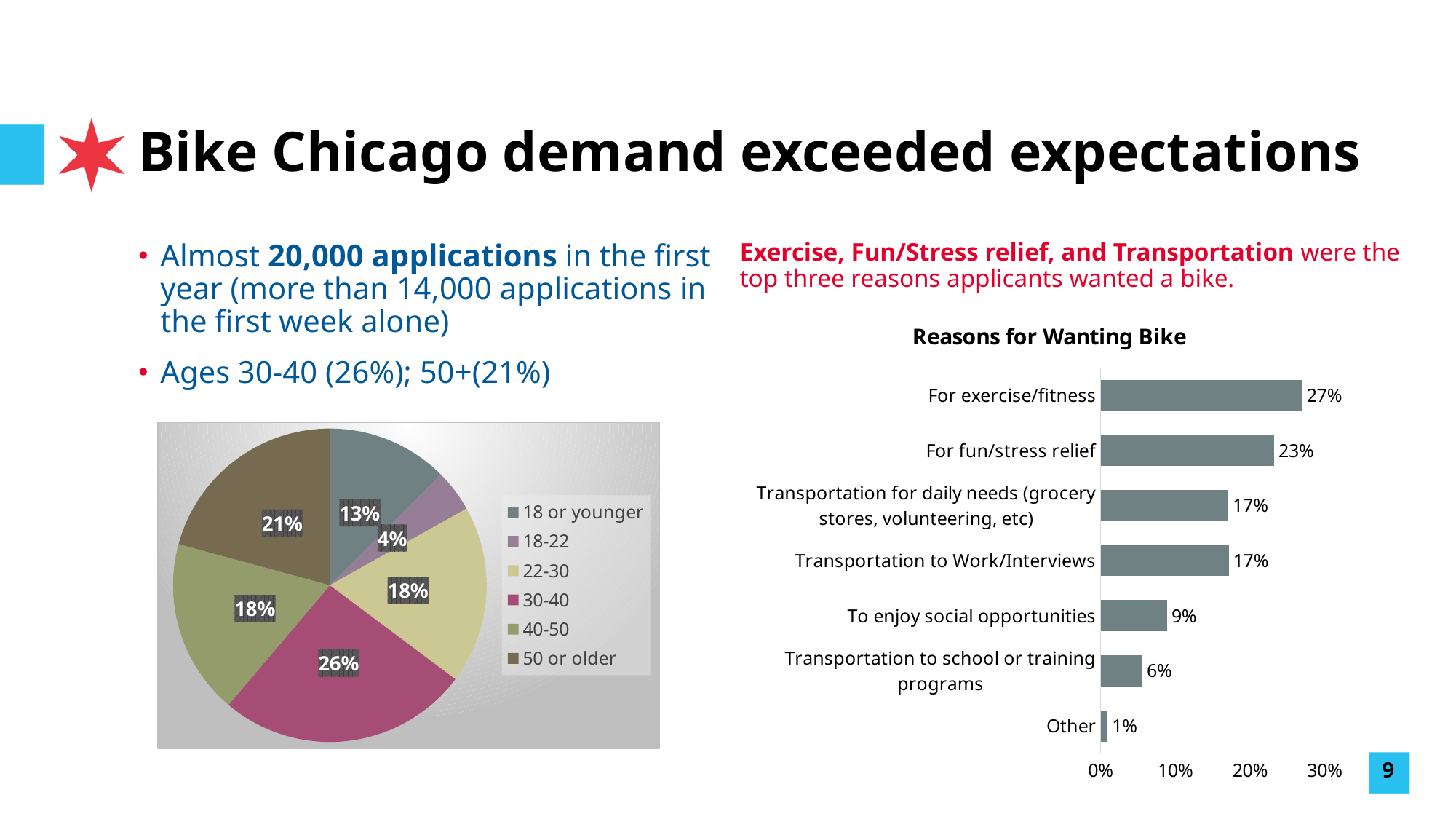
In the pie chart on the left, what share does the '30-40' age group have? 26% In the 'Reasons for Wanting Bike' bar chart, how many reasons (categories) are shown? 7 In the 'Reasons for Wanting Bike' bar chart, which reason has the lowest value? Other In the pie chart on the left, which age group has the largest slice? 30-40 What kind of chart is the 'Reasons for Wanting Bike' chart? bar chart In the 'Reasons for Wanting Bike' bar chart, what is the difference between 'For exercise/fitness' and 'For fun/stress relief'? 4% In the pie chart on the left, which age group has the smallest slice? 18-22 In the 'Reasons for Wanting Bike' bar chart, which reason has the highest value? For exercise/fitness In the pie chart on the left, which is larger: the '50 or older' slice or the '18 or younger' slice? 50 or older In the 'Reasons for Wanting Bike' bar chart, what is the value for 'For exercise/fitness'? 27% In the pie chart on the left, how many age groups does the legend list? 6 In the 'Reasons for Wanting Bike' bar chart, is the value for 'To enjoy social opportunities' greater or less than 10%? less